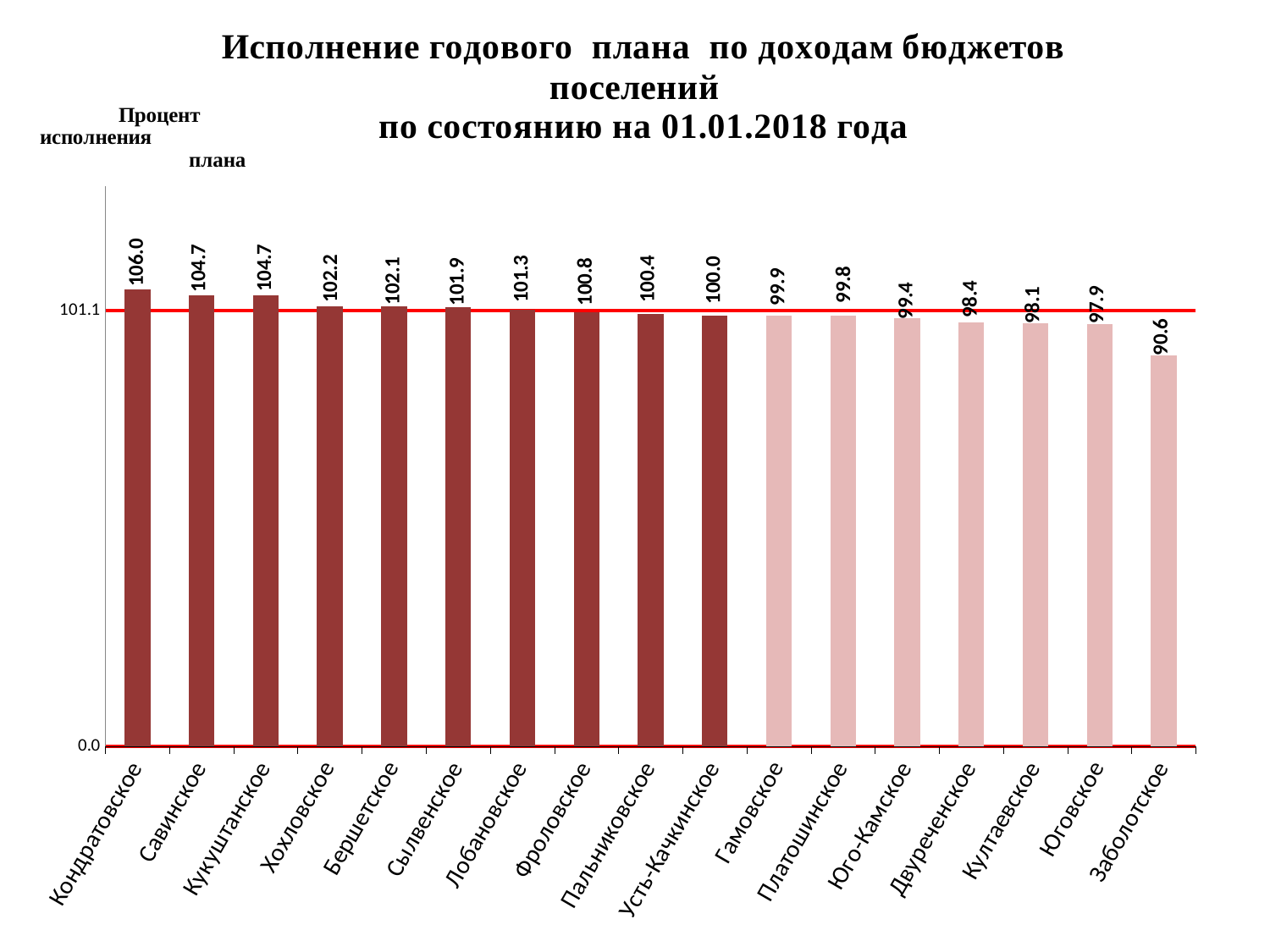
Which is larger, the value for Сылвенское or the value for Гамовское? Сылвенское What is the value for Кондратовское? 106.0 What is the difference between the values for Кондратовское and Заболотское? 15.4 What kind of chart is shown on the slide? bar chart How many categories are shown on the x axis? 17 Which category has the lowest value? Заболотское What is the value for Заболотское? 90.6 What is the difference between the values for Хохловское and Юговское? 4.3 What is the value for Двуреченское? 98.4 What is the value for Лобановское? 101.3 Which category has the highest value? Кондратовское Do the values rise or fall from left to right along the x axis? fall